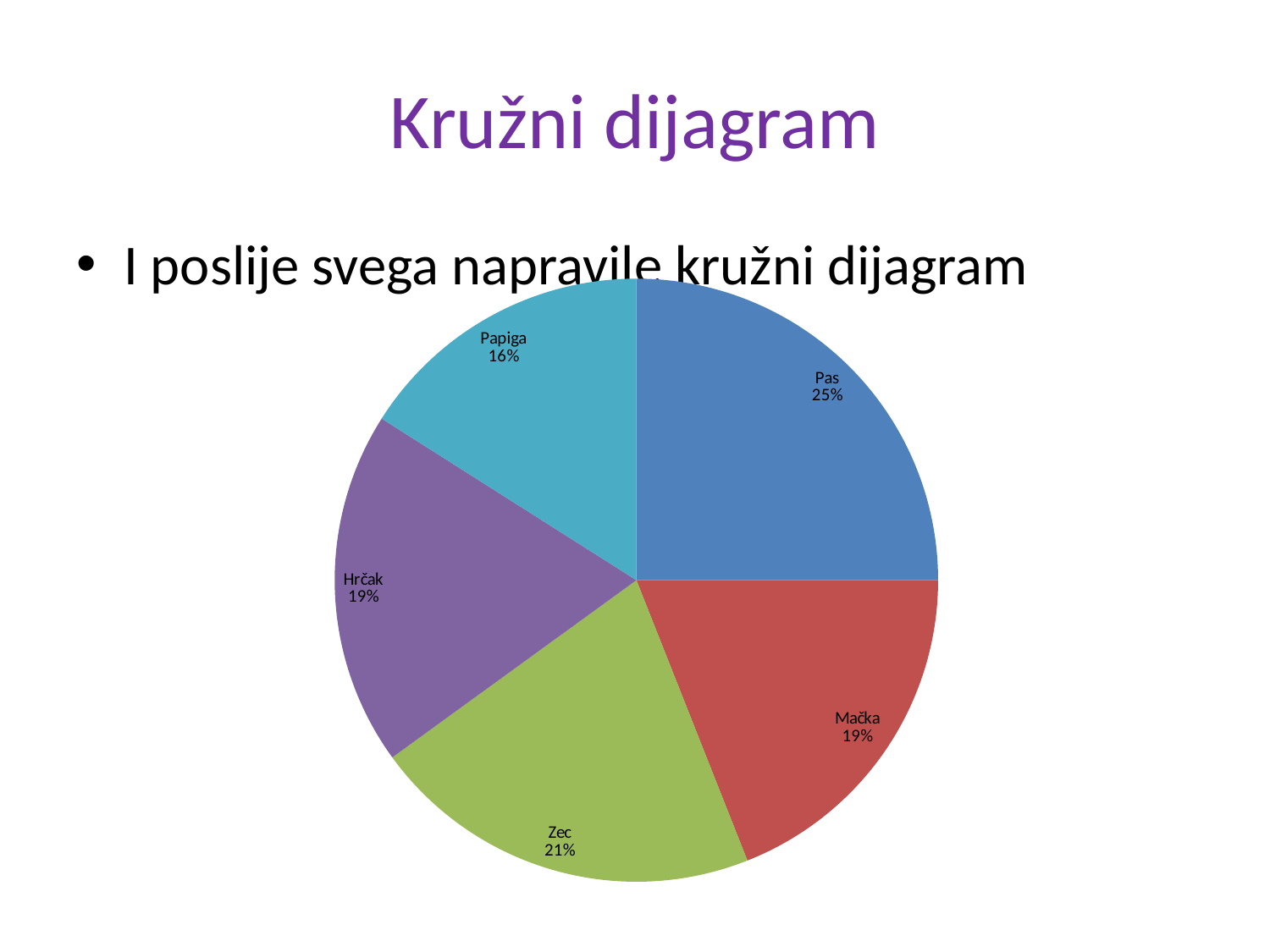
What share of the pie does Pas have? 25% Which category has the largest slice of the pie? Pas How many slices does the pie chart have? 5 What is the difference in percentage points between the Pas slice and the Papiga slice? 9 Which slice is larger, Zec or Mačka? Zec What share of the pie does Mačka have? 19% What share of the pie does Hrčak have? 19% Which category has the smallest slice of the pie? Papiga What kind of chart is shown on the slide? pie chart What colour is the Pas slice? blue